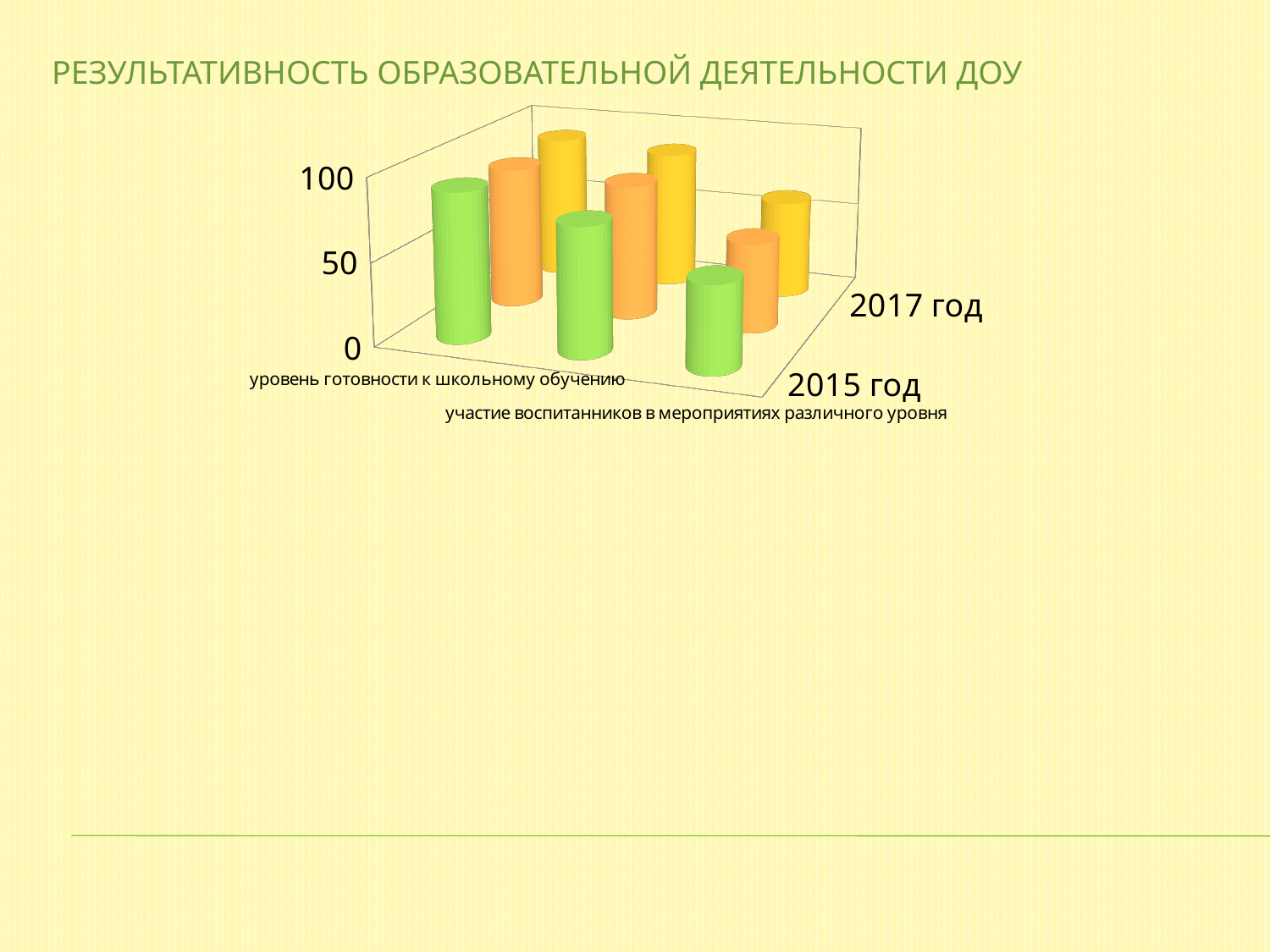
Is the value for участие воспитанников в мероприятиях различного уровня in 2017 год greater or less than 50? greater What kind of chart is shown on the slide? bar chart How many rows of bars (series) are plotted in the chart? 3 Is the value for уровень готовности к школьному обучению in 2017 год greater or less than 50? greater Is the value for уровень готовности к школьному обучению in 2015 год greater or less than 50? greater How many categories are plotted along the front axis of the chart? 3 What is the highest tick value shown on the vertical axis of the chart? 100 What is the title of the slide containing the chart? РЕЗУЛЬТАТИВНОСТЬ ОБРАЗОВАТЕЛЬНОЙ ДЕЯТЕЛЬНОСТИ ДОУ